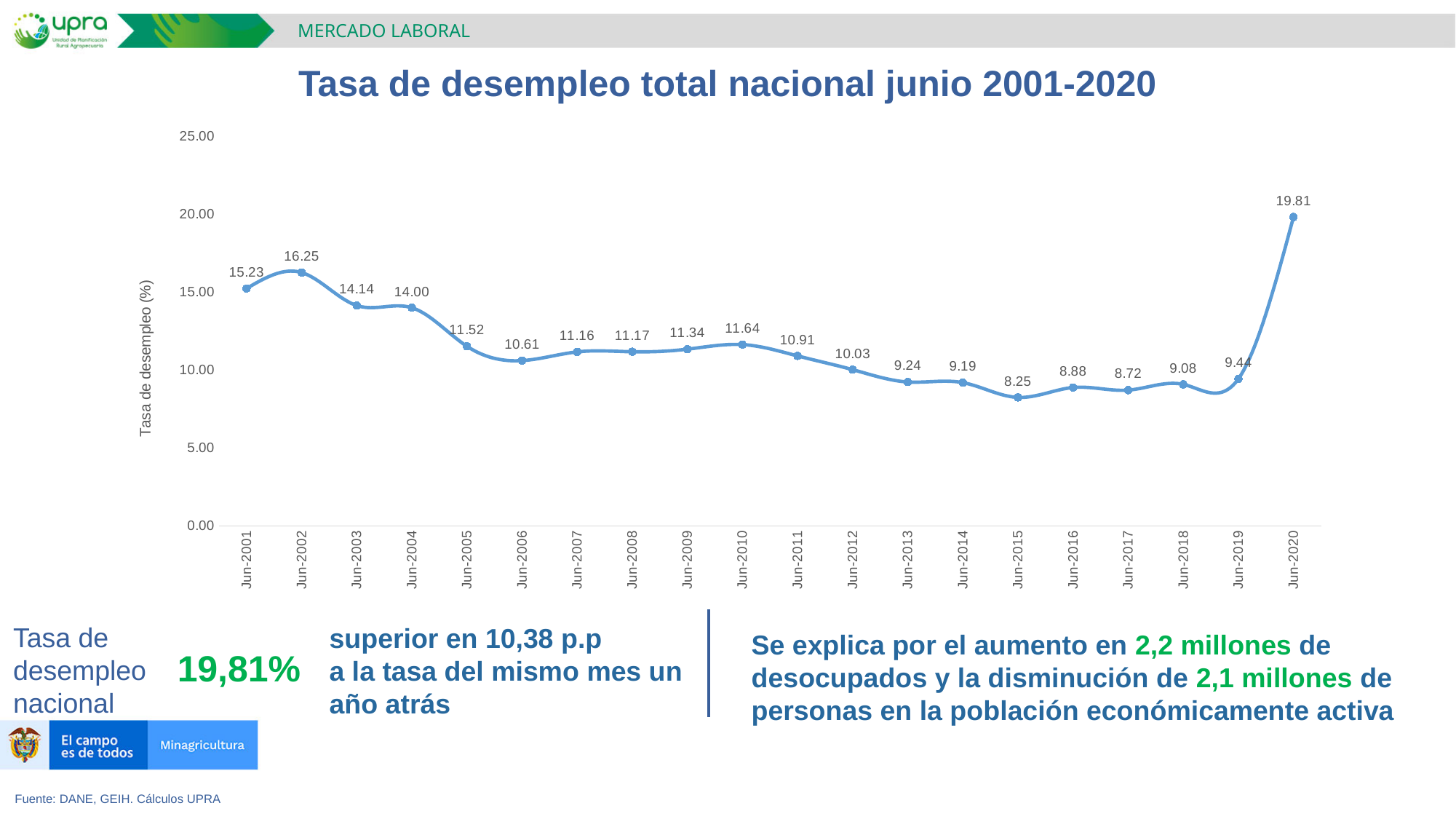
Which year has the lowest unemployment rate on the chart? Jun-2015 Which is higher, the unemployment rate in Jun-2002 or Jun-2003? Jun-2002 What is the unemployment rate shown for Jun-2020? 19.81 What is the difference between the unemployment rate in Jun-2020 and Jun-2019? 10.37 What is the unemployment rate shown for Jun-2015? 8.25 What is the unemployment rate shown for Jun-2001? 15.23 What kind of chart is shown on the slide? Line chart What is the title of the chart? Tasa de desempleo total nacional junio 2001-2020 Does the unemployment rate rise or fall from Jun-2002 to Jun-2006? Fall How many data points are plotted on the chart? 20 Which year has the highest unemployment rate on the chart? Jun-2020 Is the value for Jun-2010 greater or less than 10.00? greater